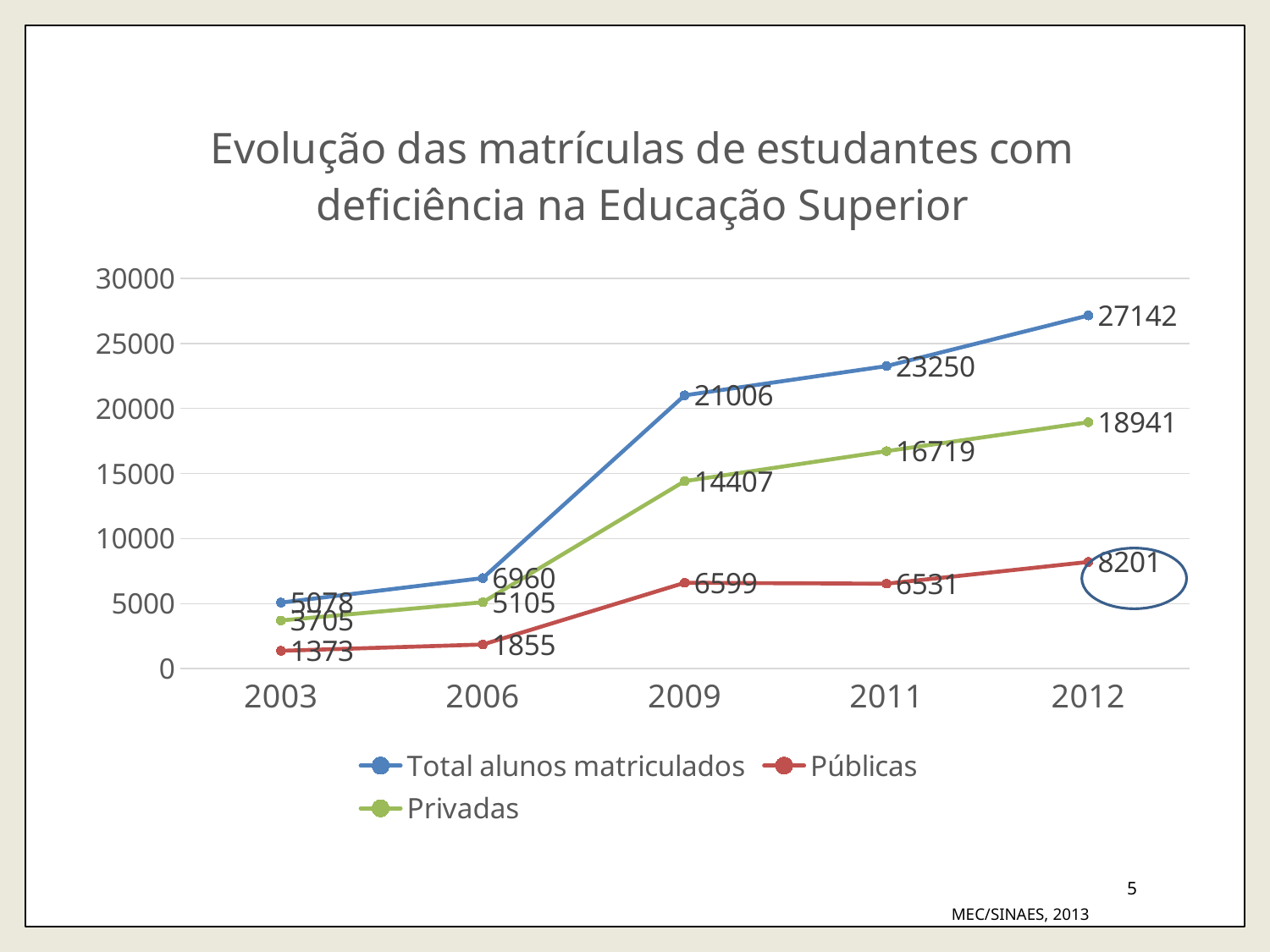
Which is larger in 2006, Privadas or Públicas? Privadas What is the value for Total alunos matriculados in 2012? 27142 In which year is the Privadas series highest? 2012 In which year is the Públicas series lowest? 2003 What is the difference between Privadas and Públicas in 2012? 10740 What is the value for Públicas in 2009? 6599 Does the Total alunos matriculados series rise or fall from 2003 to 2012? rise How many series does the legend list? 3 Which value on the chart is circled? 8201 How many years are plotted along the x axis? 5 What is the value for Privadas in 2011? 16719 What type of chart is shown on the slide? line chart